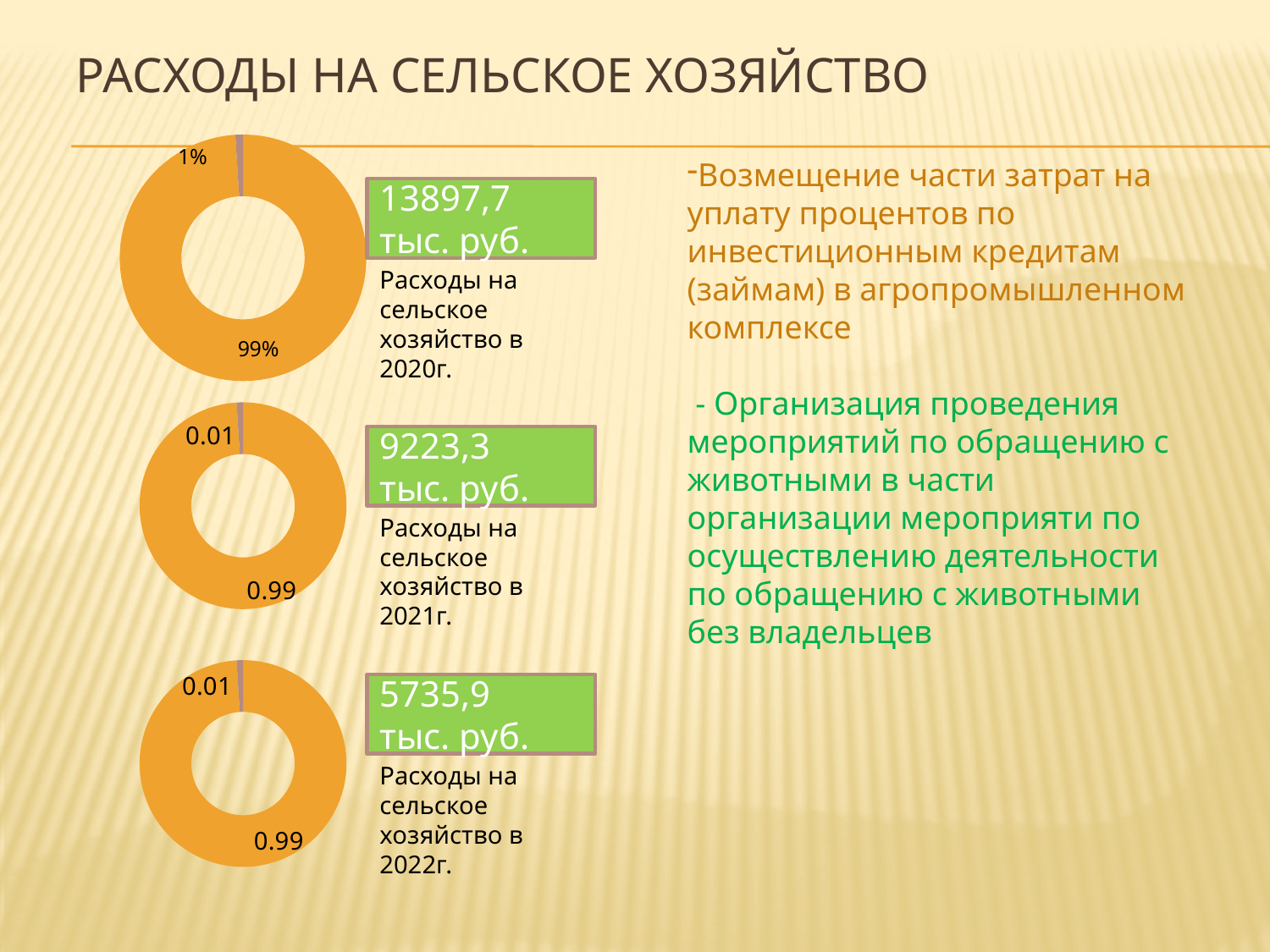
In the middle doughnut chart (2021), what is the data label on the small grey slice? 0.01 In the top doughnut chart (2020), what is the data label on the large orange slice? 99% In the bottom doughnut chart (2022), which slice is larger, the orange one or the grey one? the orange one What colour is the largest slice in the middle doughnut chart (2021)? orange In the middle doughnut chart (2021), what is the data label on the large orange slice? 0.99 In the top doughnut chart (2020), what is the data label on the small grey slice? 1% How many slices does the top doughnut chart (2020) have? 2 What is the difference between the two slice labels in the top doughnut chart (2020)? 98% How many doughnut charts are shown on the slide? 3 In the bottom doughnut chart (2022), what is the data label on the large orange slice? 0.99 In the bottom doughnut chart (2022), what is the data label on the small grey slice? 0.01 What kind of chart is the top chart on the slide (next to the 2020 figure)? doughnut chart